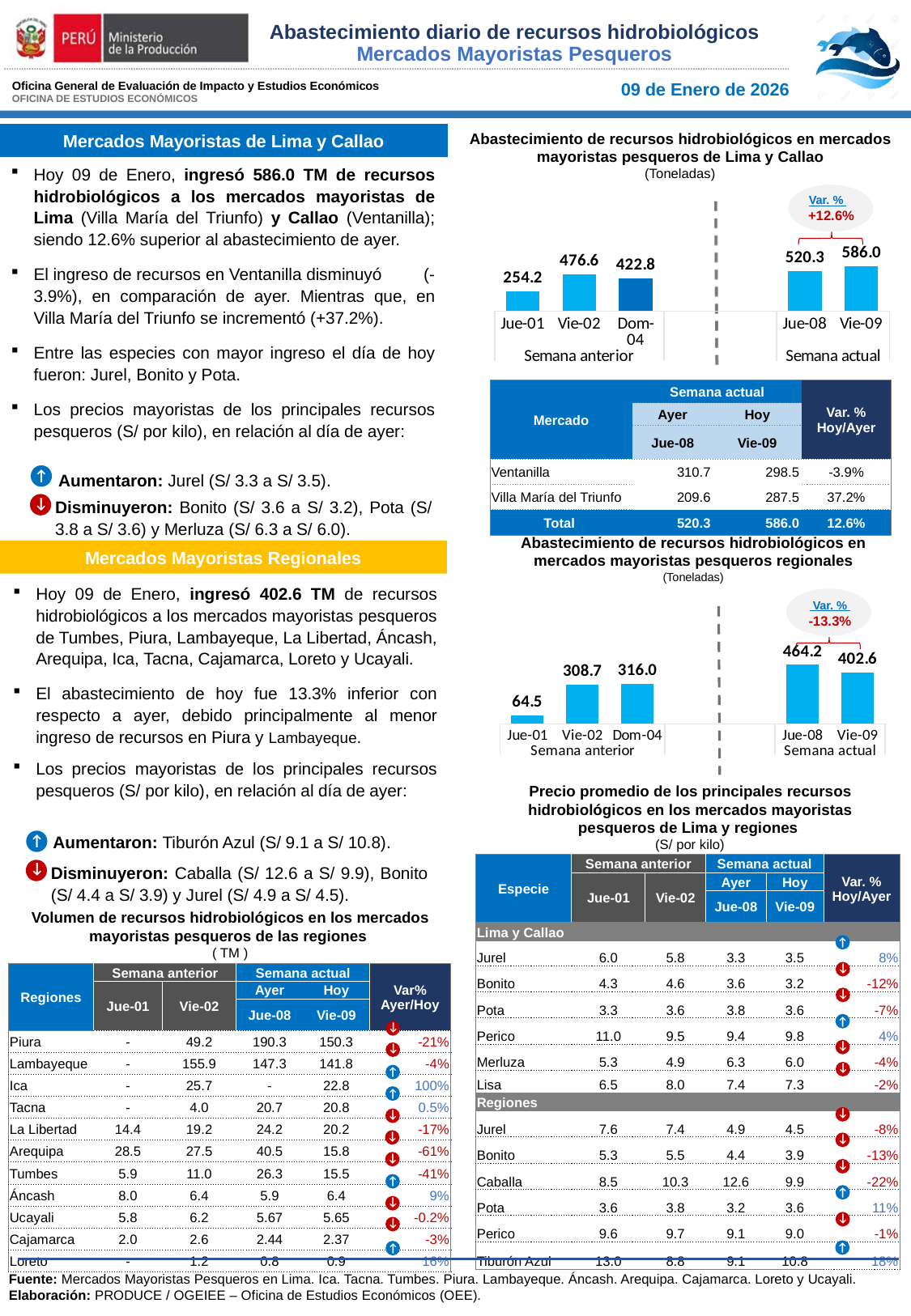
In the chart 'Abastecimiento de recursos hidrobiológicos en mercados mayoristas pesqueros de Lima y Callao', what is the difference between Vie-09 and Jue-08? 65.7 In the chart 'Abastecimiento de recursos hidrobiológicos en mercados mayoristas pesqueros de Lima y Callao', which day has the highest value? Vie-09 What type of chart is 'Abastecimiento de recursos hidrobiológicos en mercados mayoristas pesqueros regionales'? Bar chart In the chart 'Abastecimiento de recursos hidrobiológicos en mercados mayoristas pesqueros de Lima y Callao', which day has the lowest value? Jue-01 In the chart 'Abastecimiento de recursos hidrobiológicos en mercados mayoristas pesqueros de Lima y Callao', how many days are plotted? 5 In the chart 'Abastecimiento de recursos hidrobiológicos en mercados mayoristas pesqueros regionales', which is larger: Vie-02 or Dom-04? Dom-04 In the chart 'Abastecimiento de recursos hidrobiológicos en mercados mayoristas pesqueros regionales', which day has the lowest value? Jue-01 In the chart 'Abastecimiento de recursos hidrobiológicos en mercados mayoristas pesqueros de Lima y Callao', what percentage variation is shown between Jue-08 and Vie-09? +12.6% In the chart 'Abastecimiento de recursos hidrobiológicos en mercados mayoristas pesqueros regionales', what is the value for Jue-08? 464.2 In the chart 'Abastecimiento de recursos hidrobiológicos en mercados mayoristas pesqueros regionales', what is the difference between Jue-08 and Vie-09? 61.6 In the chart 'Abastecimiento de recursos hidrobiológicos en mercados mayoristas pesqueros de Lima y Callao', what is the value for Jue-01? 254.2 In the chart 'Abastecimiento de recursos hidrobiológicos en mercados mayoristas pesqueros de Lima y Callao', what is the value for Vie-09? 586.0